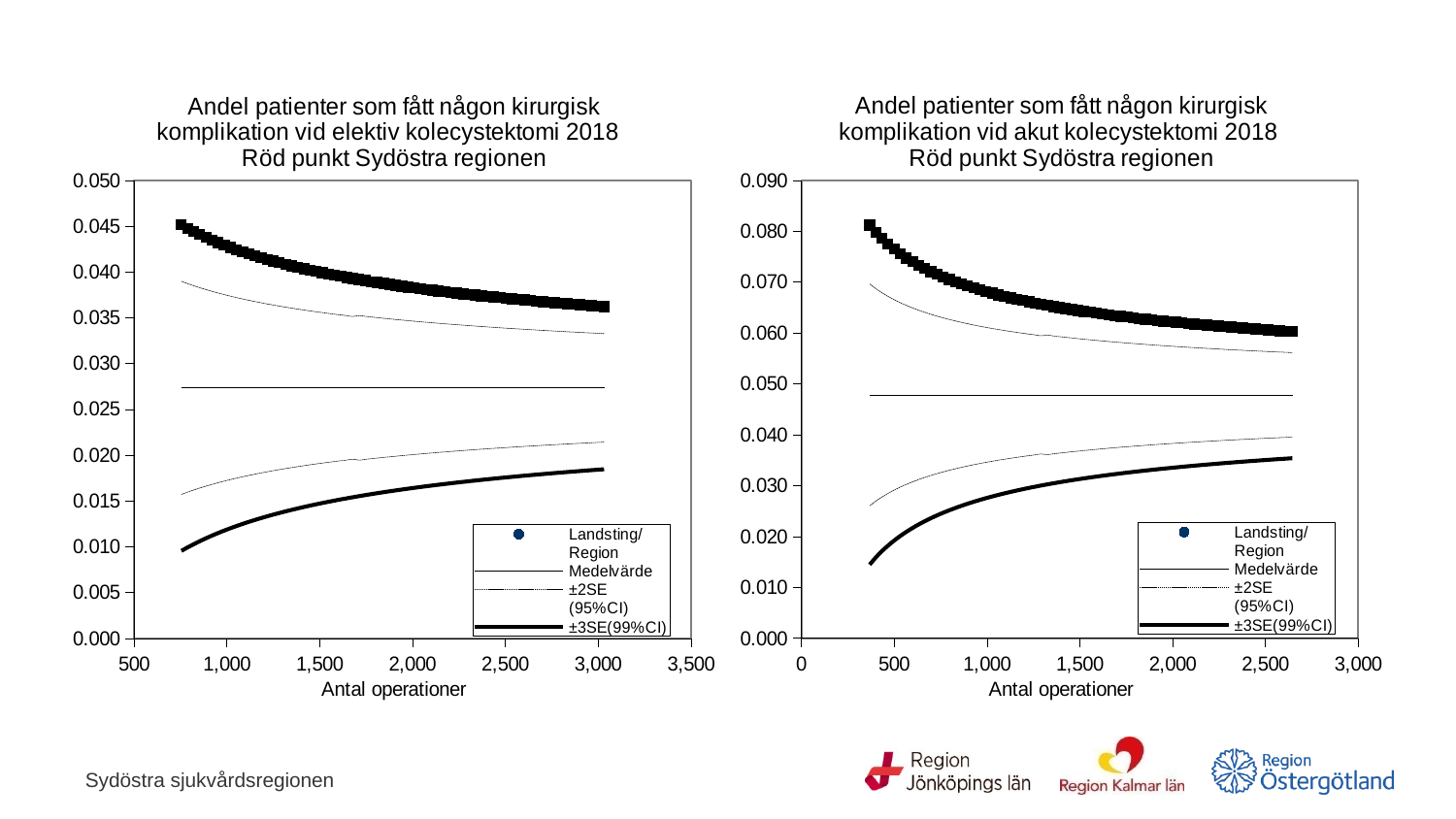
In the left chart (elektiv kolecystektomi 2018), is the Medelvärde line greater or less than 0.025? greater In the left chart (elektiv kolecystektomi 2018), what is the highest value shown on the y axis? 0.050 In the left chart (elektiv kolecystektomi 2018), is the lower ±3SE(99%CI) limit at 1,000 operations greater or less than 0.015? less In the right chart (akut kolecystektomi 2018), is the Medelvärde line greater or less than 0.040? greater In the right chart (akut kolecystektomi 2018), does the upper ±3SE(99%CI) limit rise or fall as the number of operations increases? fall In the right chart (akut kolecystektomi 2018), what is the label of the x axis? Antal operationer In the left chart (elektiv kolecystektomi 2018), how many series does the legend list? 4 Which chart has the higher Medelvärde line, the left chart (elektiv) or the right chart (akut)? the right chart (akut) In the left chart (elektiv kolecystektomi 2018), does the lower ±3SE(99%CI) limit rise or fall as the number of operations increases? rise